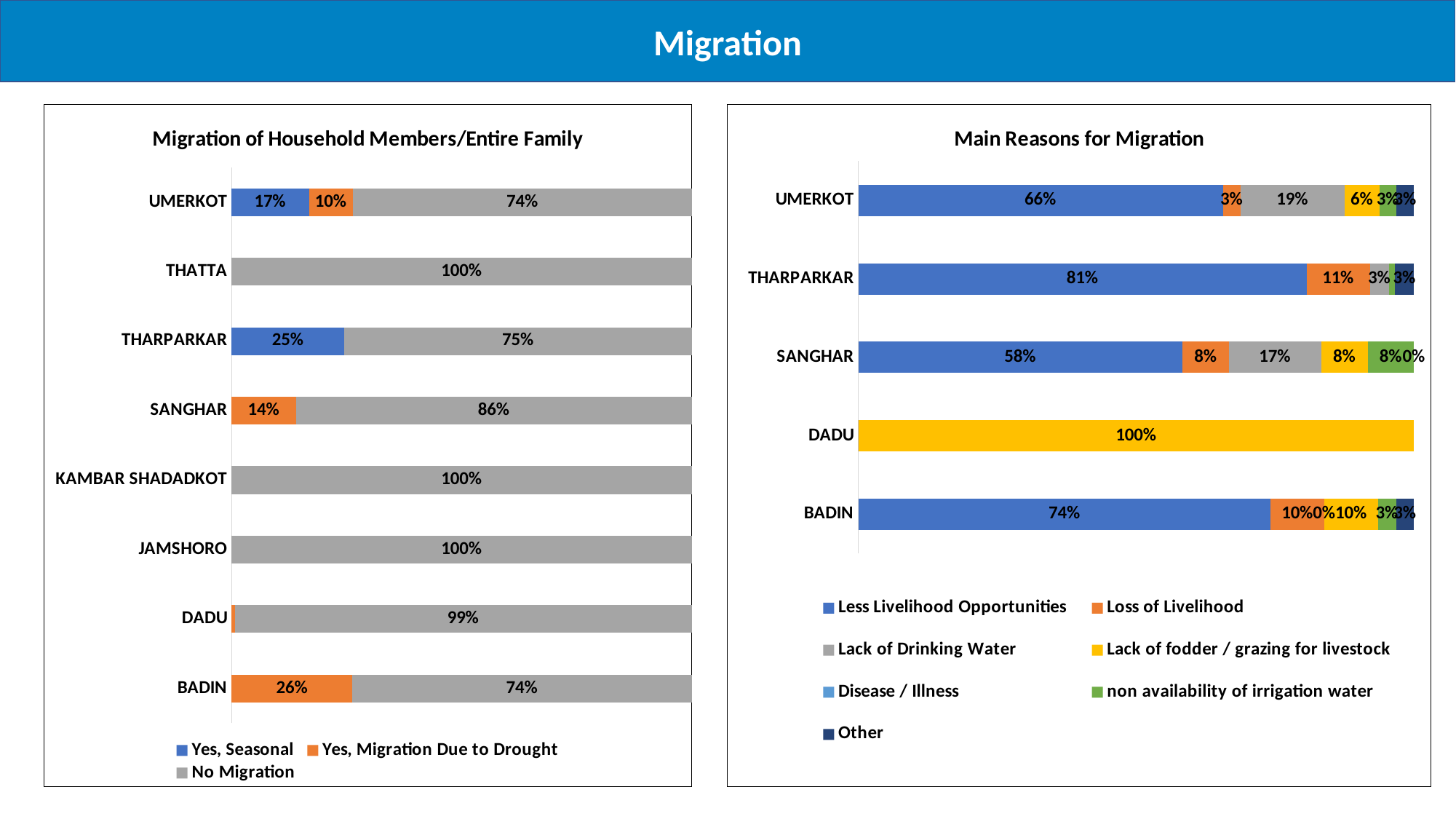
In the 'Migration of Household Members/Entire Family' chart, what is the difference between the 'No Migration' values for SANGHAR and UMERKOT? 12% In the 'Migration of Household Members/Entire Family' chart, how many series does the legend list? 3 What type of chart is the 'Main Reasons for Migration' chart? Stacked bar chart In the 'Main Reasons for Migration' chart, which district has the highest 'Less Livelihood Opportunities' value? THARPARKAR In the 'Migration of Household Members/Entire Family' chart, what is the 'Yes, Migration Due to Drought' value for BADIN? 26% In the 'Main Reasons for Migration' chart, what is the 'Less Livelihood Opportunities' value for THARPARKAR? 81% In the 'Migration of Household Members/Entire Family' chart, what is the 'Yes, Seasonal' value for THARPARKAR? 25% In the 'Migration of Household Members/Entire Family' chart, which is larger: the 'Yes, Migration Due to Drought' value for BADIN or for SANGHAR? BADIN In the 'Main Reasons for Migration' chart, how many series does the legend list? 7 In the 'Main Reasons for Migration' chart, what is the 'Lack of Drinking Water' value for SANGHAR? 17% In the 'Migration of Household Members/Entire Family' chart, how many districts are listed on the vertical axis? 8 In the 'Migration of Household Members/Entire Family' chart, what is the 'No Migration' value for UMERKOT? 74%